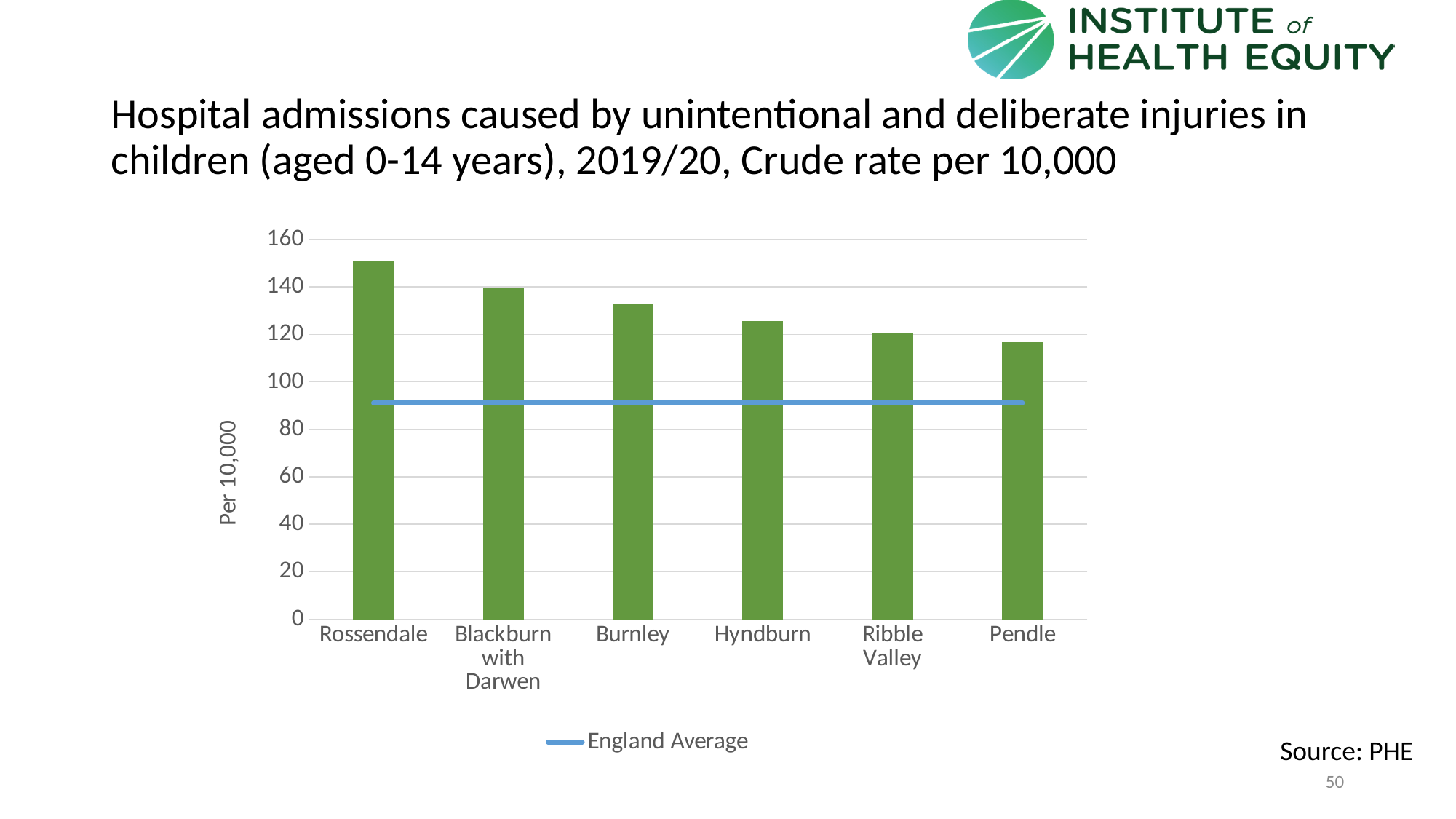
Which is larger, the value for Burnley or the value for Hyndburn? Burnley What kind of chart is shown on the slide? bar chart What is the label on the y axis of the chart? Per 10,000 Is the England Average line greater or less than 100? less Which area has the highest rate of hospital admissions in the chart? Rossendale Do the bar values rise or fall moving from left to right along the x axis? fall Is the value for Pendle greater or less than 120? less How many local areas are shown on the x axis of the chart? 6 Is the value for Burnley greater or less than 140? less How many entries does the chart legend list? 1